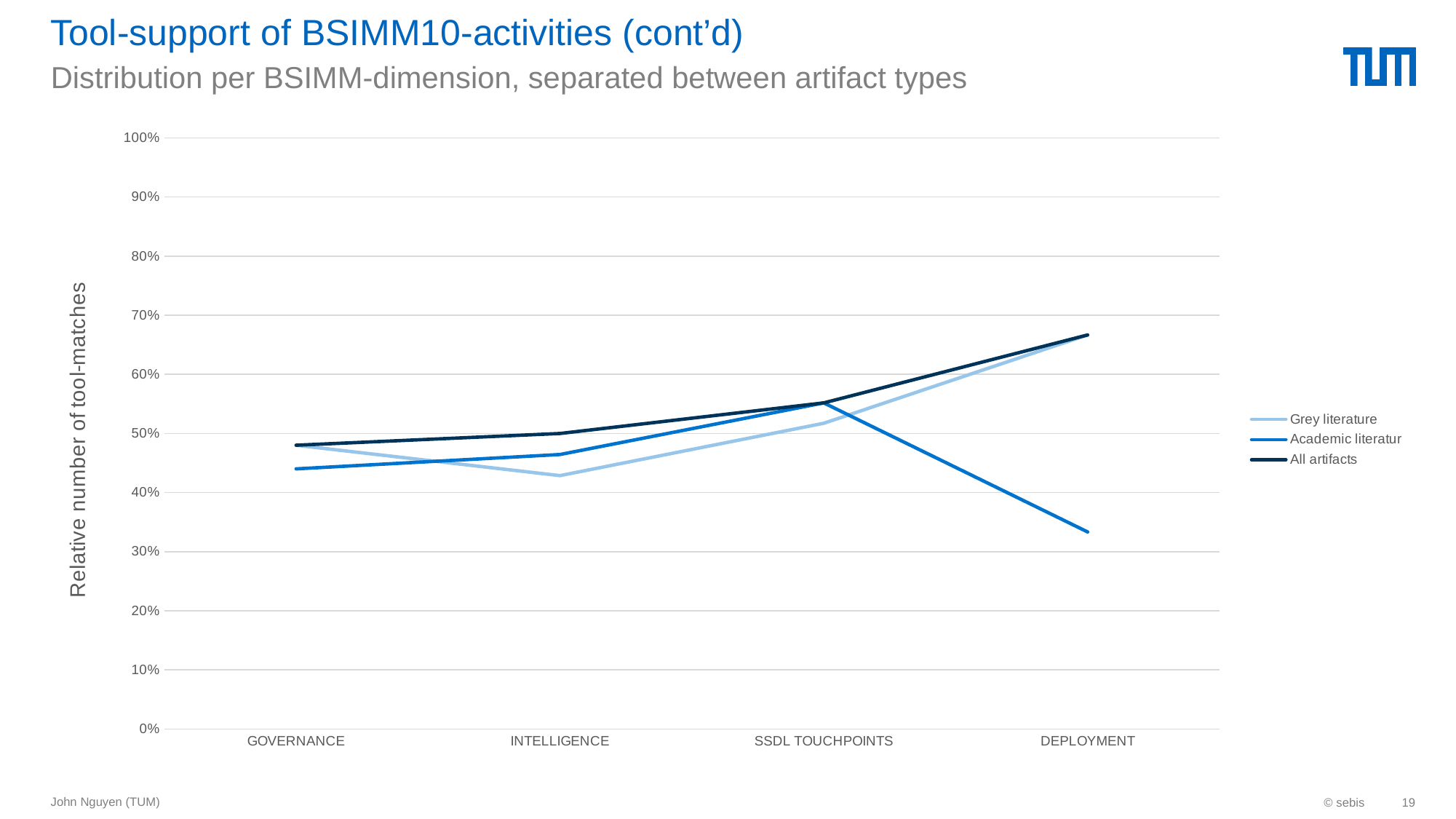
At which dimension is the Academic literatur series highest? SSDL TOUCHPOINTS What is the title of the vertical axis? Relative number of tool-matches How many series does the legend list? 3 Is the value for Grey literature at INTELLIGENCE greater or less than 50%? less Is the value for Grey literature at DEPLOYMENT greater or less than 60%? greater What kind of chart is shown on the slide? line chart At which dimension is the Academic literatur series lowest? DEPLOYMENT Is the value for Academic literatur at SSDL TOUCHPOINTS greater or less than 50%? greater How many BSIMM dimensions are shown on the x axis? 4 Does the All artifacts series rise or fall from GOVERNANCE to DEPLOYMENT? rise At DEPLOYMENT, which is larger: Grey literature or Academic literatur? Grey literature